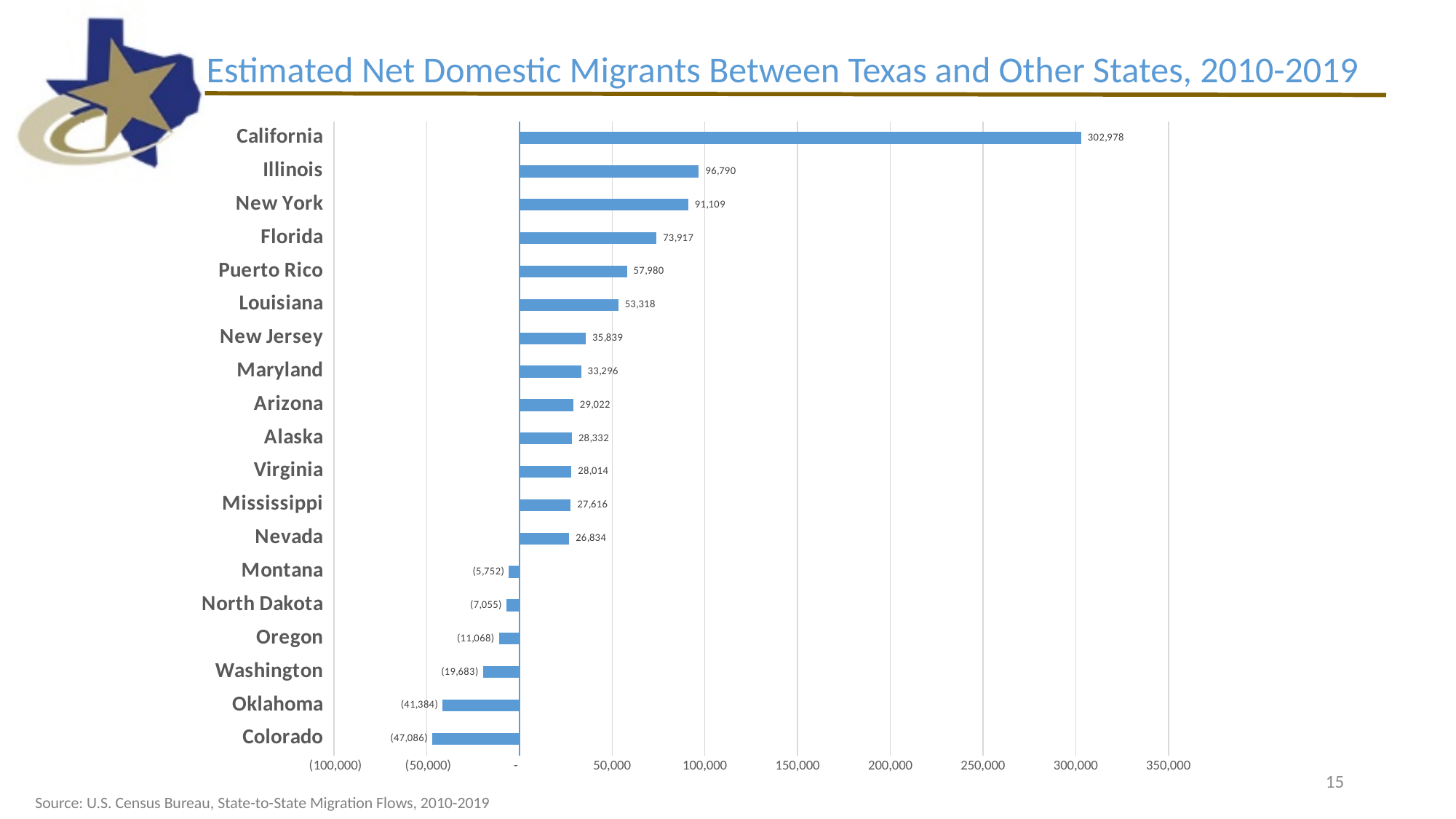
How many categories have negative values? 6 What kind of chart is shown on the slide? Bar chart What is the difference between the values for Illinois and New York? 5,681 What is the value shown for Colorado? (47,086) What is the title of the chart? Estimated Net Domestic Migrants Between Texas and Other States, 2010-2019 Which state has the lowest net domestic migration value? Colorado Which has a larger value, Florida or Louisiana? Florida How many states or territories are shown in the chart? 19 Which state has the highest net domestic migration value? California What is the value shown for Puerto Rico? 57,980 Is the value for New Jersey greater or less than 50,000? less What is the estimated net domestic migration value for California? 302,978